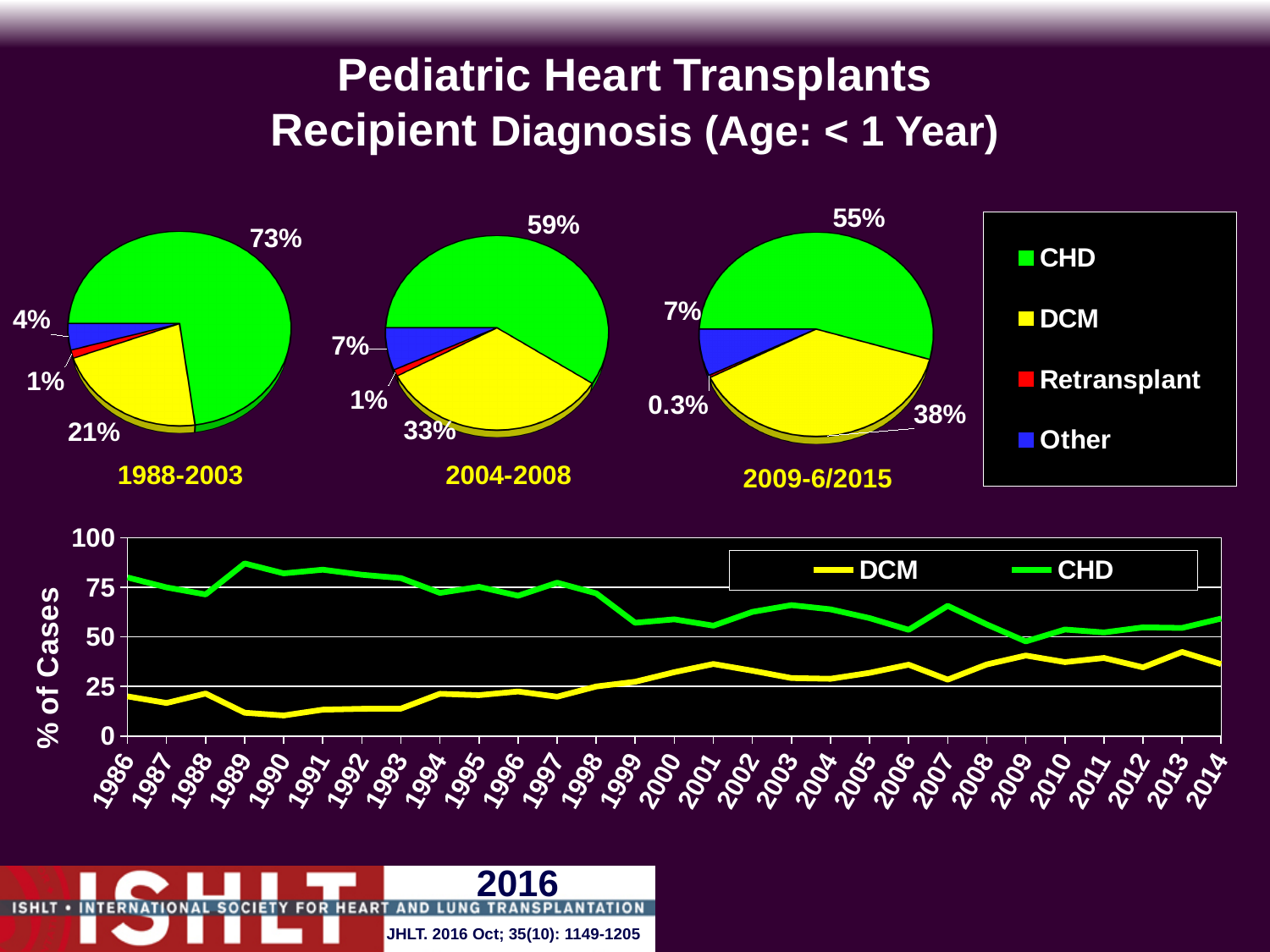
In the line chart at the bottom, does the DCM series generally rise or fall from 1986 to 2014? rise In the 2009-6/2015 pie chart, which diagnosis has the largest share? CHD In the line chart at the bottom, how many series does the legend list? 2 In the 1988-2003 pie chart, which diagnosis has the smallest share? Retransplant Which pie chart shows a larger DCM share, 1988-2003 or 2009-6/2015? 2009-6/2015 In the 2004-2008 pie chart, what share of cases is DCM? 33% In the 2009-6/2015 pie chart, what share of cases is Retransplant? 0.3% In the 2004-2008 pie chart, what is the difference between the CHD share and the DCM share? 26% In the 1988-2003 pie chart, what share of cases is CHD? 73% How many diagnosis categories does the pie chart legend list? 4 In the line chart at the bottom, is the CHD value for 1989 greater or less than 75? greater What type of chart is shown at the bottom of the slide? line chart